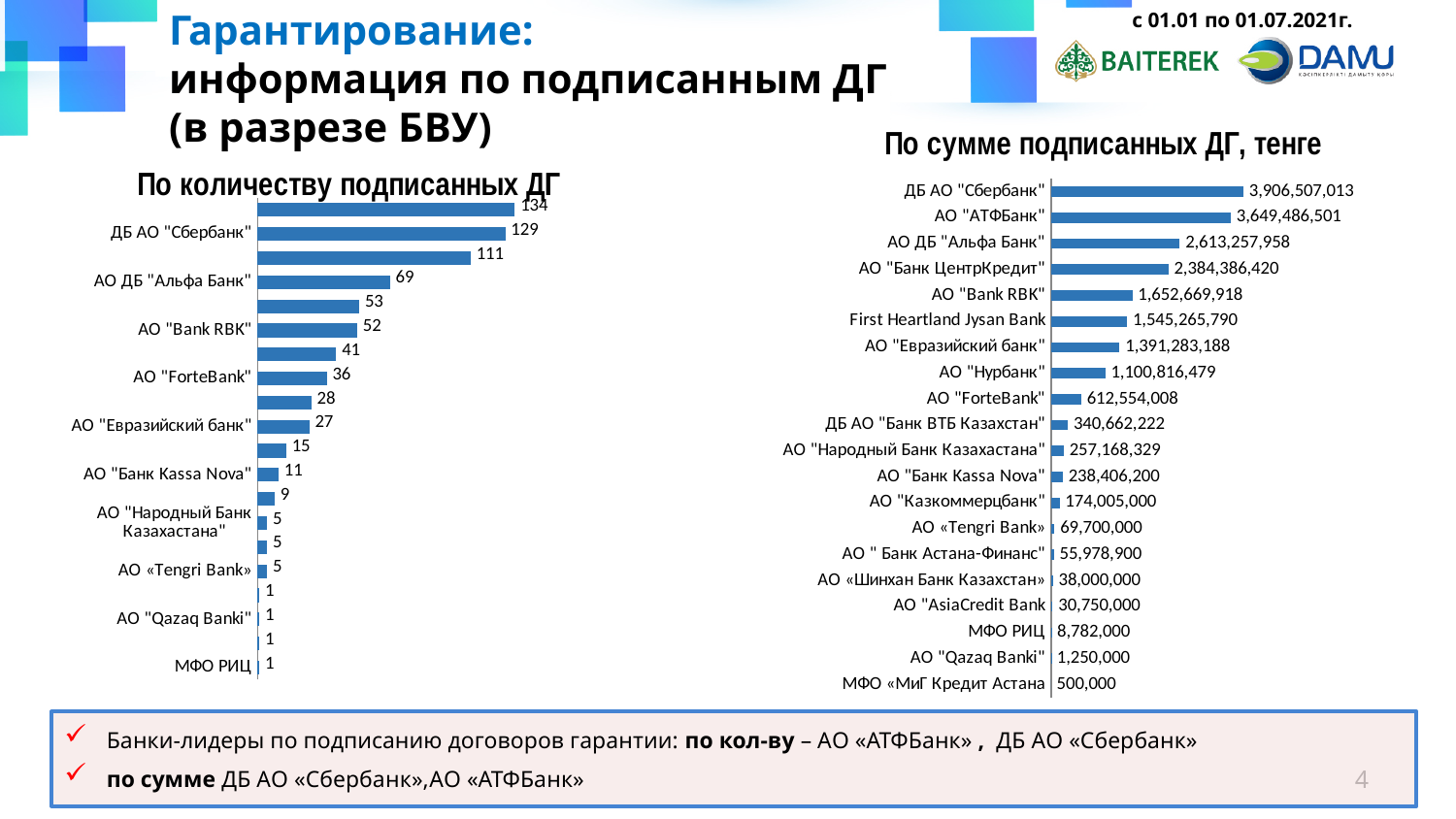
In the chart "По сумме подписанных ДГ, тенге", which category has the lowest value? МФО «МиГ Кредит Астана» How many categories are shown in the chart "По сумме подписанных ДГ, тенге"? 20 What type of chart is "По сумме подписанных ДГ, тенге"? Bar chart In the chart "По сумме подписанных ДГ, тенге", what is the value for АО "Bank RBK"? 1,652,669,918 In the chart "По количеству подписанных ДГ", what is the value for АО "ForteBank"? 36 In the chart "По сумме подписанных ДГ, тенге", what is the difference between ДБ АО "Сбербанк" and АО "АТФБанк"? 257,020,512 In the chart "По сумме подписанных ДГ, тенге", which is larger: First Heartland Jysan Bank or АО "Евразийский банк"? First Heartland Jysan Bank In the chart "По сумме подписанных ДГ, тенге", which bank has the highest value? ДБ АО "Сбербанк" In the chart "По количеству подписанных ДГ", which is larger: АО "Bank RBK" or АО "Евразийский банк"? АО "Bank RBK" In the chart "По количеству подписанных ДГ", what is the value for АО ДБ "Альфа Банк"? 69 In the chart "По количеству подписанных ДГ", what is the difference between ДБ АО "Сбербанк" and АО ДБ "Альфа Банк"? 60 In the chart "По сумме подписанных ДГ, тенге", what is the value for ДБ АО "Сбербанк"? 3,906,507,013